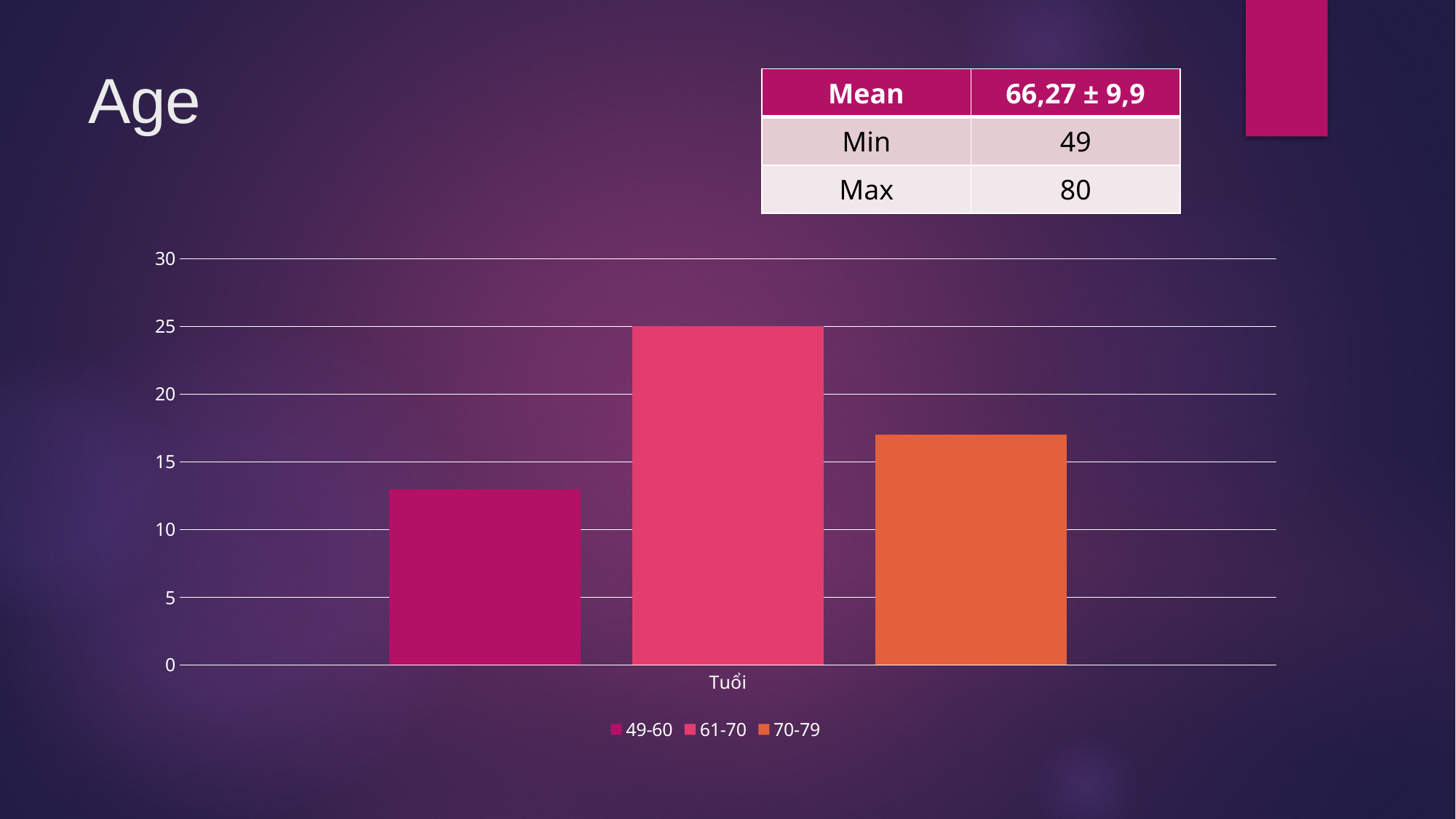
How many categories are shown on the x axis of the chart? 1 Which is larger, the value for 70-79 or the value for 49-60? 70-79 Is the value for 70-79 greater or less than 15? greater Is the value for 49-60 greater or less than 10? greater Is the value for 70-79 greater or less than 20? less What are the legend entries of the chart? 49-60, 61-70, 70-79 Which age group has the highest bar in the chart? 61-70 What kind of chart is shown on the slide? bar chart Which age group has the lowest bar in the chart? 49-60 What is the category label shown on the x axis of the chart? Tuổi How many series does the chart legend list? 3